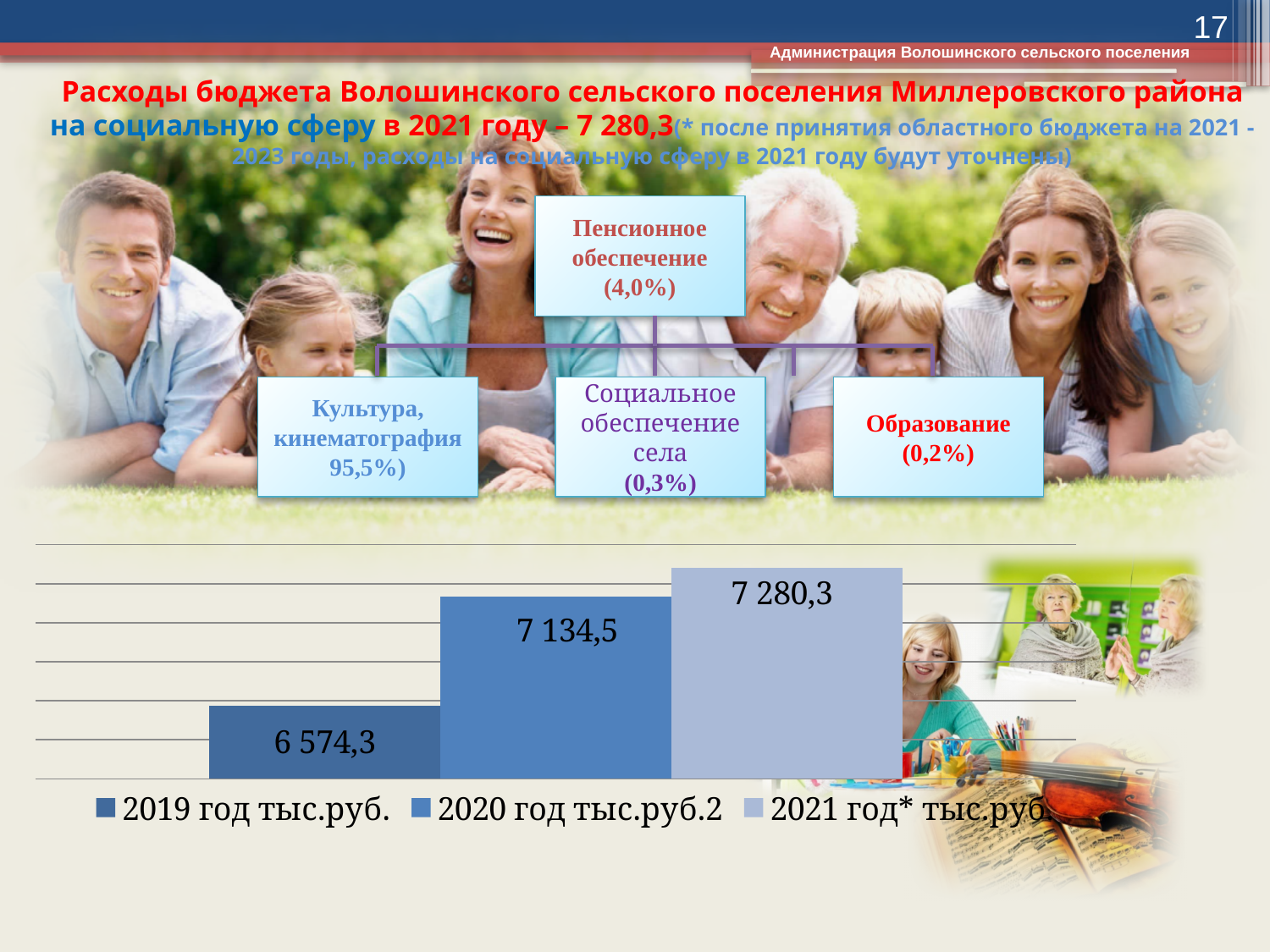
What is the difference between the 2021 and 2020 values in the bar chart? 145,8 Which year has the lowest value in the bar chart? 2019 год тыс.руб. What is the value shown for 2020 год тыс.руб.2 in the bar chart? 7 134,5 What type of chart is shown at the bottom of the slide? bar chart Do the values in the bar chart rise or fall from 2019 to 2021? rise What is the difference between the 2021 and 2019 values in the bar chart? 706,0 What is the difference between the 2020 and 2019 values in the bar chart? 560,2 Which year has the highest value in the bar chart? 2021 год* тыс.руб How many series does the legend of the bar chart list? 3 What is the value shown for 2019 год тыс.руб. in the bar chart? 6 574,3 Which is larger in the bar chart, the value for 2019 or the value for 2020? 2020 What is the value shown for 2021 год* тыс.руб in the bar chart? 7 280,3